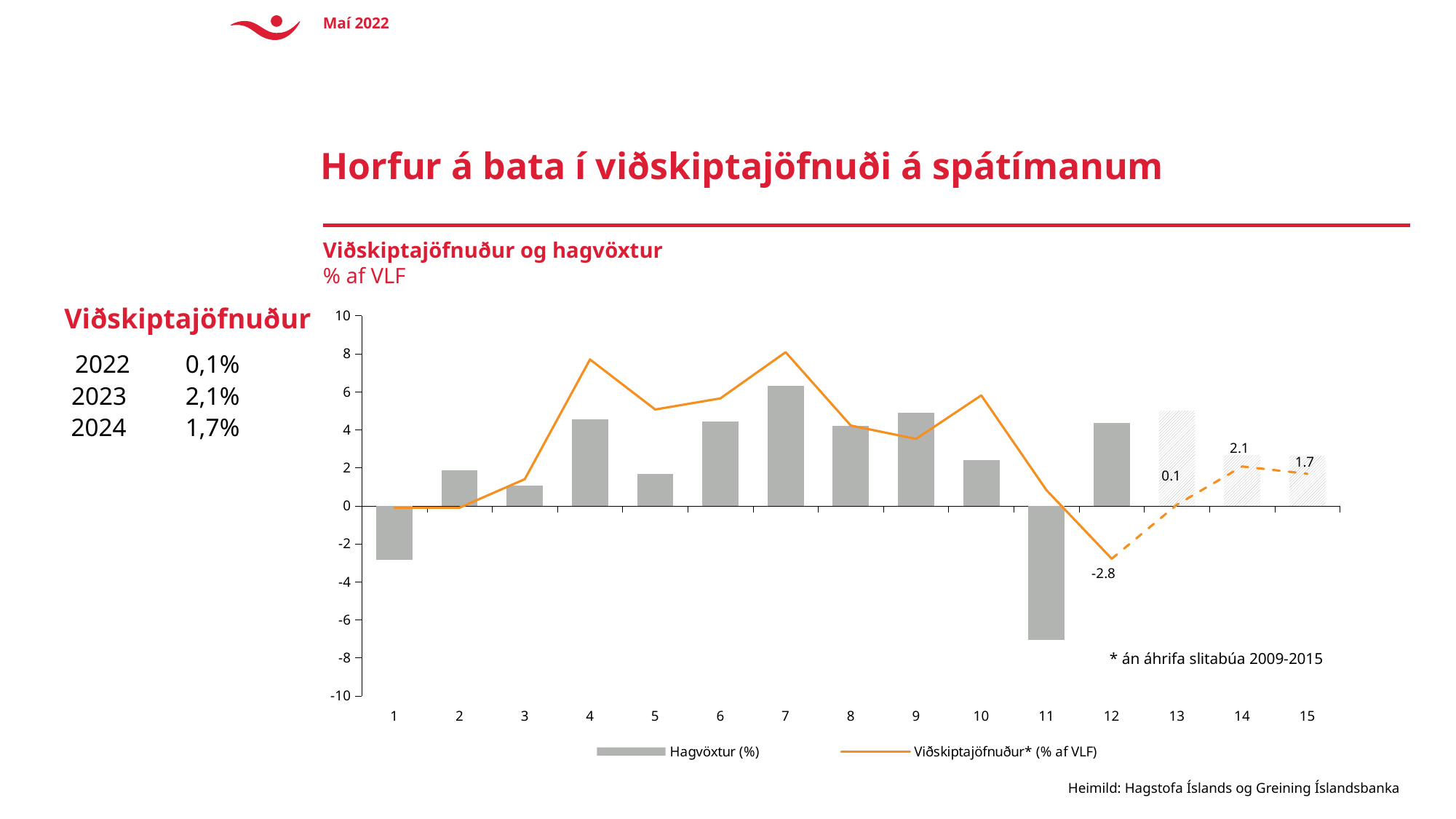
Which has the larger Hagvöxtur (%) bar, category 4 or category 5? 4 What is the value of Viðskiptajöfnuður* (% af VLF) at category 12? -2.8 Is the Hagvöxtur (%) value at category 1 greater or less than -2? less Is the Hagvöxtur (%) value at category 11 greater or less than -6? less What is the difference between the Viðskiptajöfnuður* values at categories 14 and 13? 2.0 What is the value of Viðskiptajöfnuður* (% af VLF) at category 15? 1.7 Which category has the lowest Hagvöxtur (%) bar? 11 How many categories are shown on the x axis? 15 What kind of chart is shown? Combination bar and line chart Which category has the highest Hagvöxtur (%) bar? 7 How many series does the legend list? 2 What is the value of Viðskiptajöfnuður* (% af VLF) at category 14? 2.1